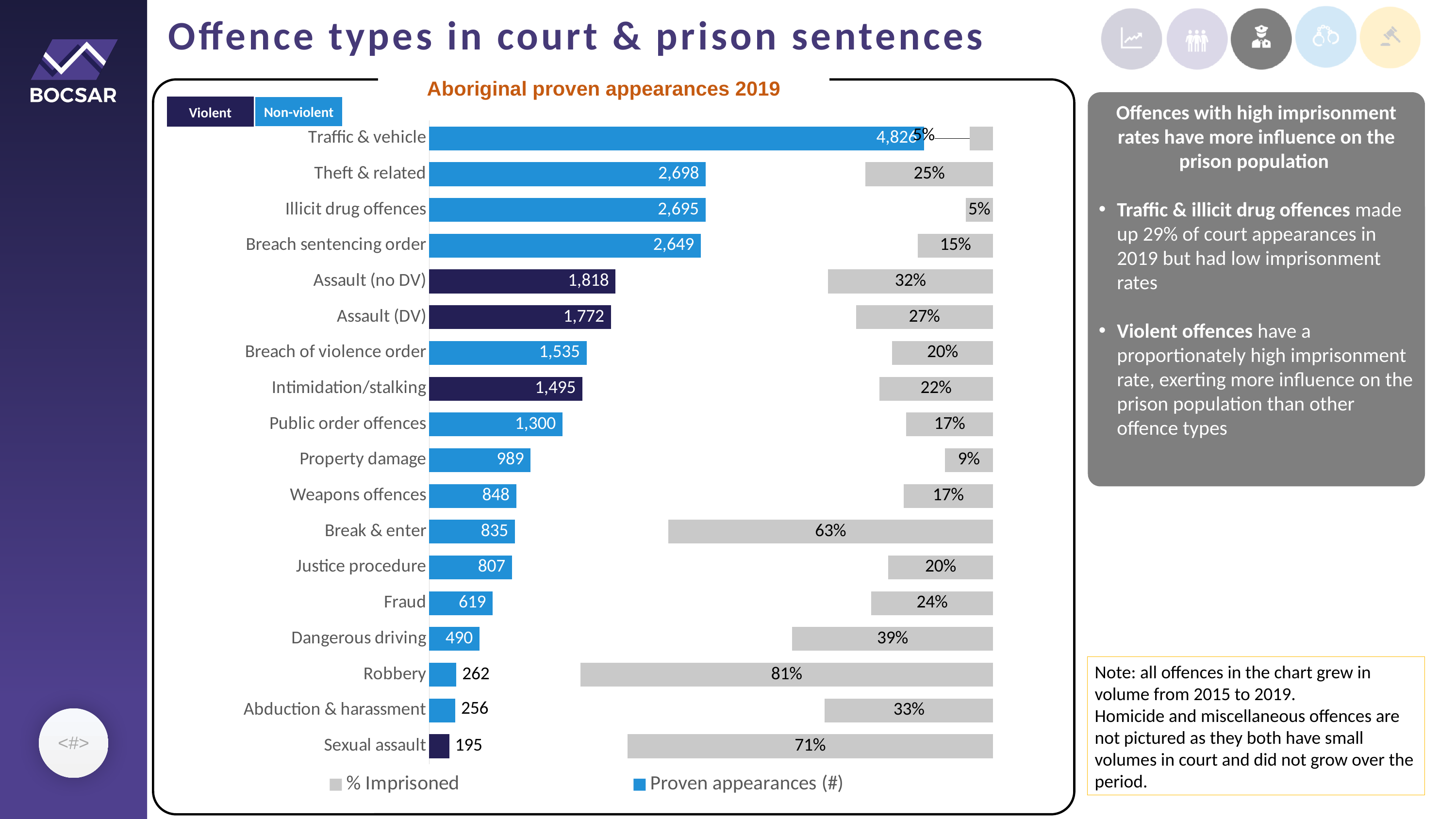
What is the number of proven appearances for Assault (DV)? 1,772 What is the difference in proven appearances between Assault (no DV) and Assault (DV)? 46 Which offence type has the highest number of proven appearances? Traffic & vehicle How many series does the chart legend list? 2 How many offence categories are shown in the chart? 18 Which offence type has the highest % imprisoned? Robbery What is the % imprisoned for Break & enter? 63% Which offence type has the lowest number of proven appearances? Sexual assault What is the title shown above the chart? Aboriginal proven appearances 2019 What type of chart is shown on the slide? bar chart Which has a higher % imprisoned, Dangerous driving or Fraud? Dangerous driving What is the number of proven appearances for Theft & related? 2,698